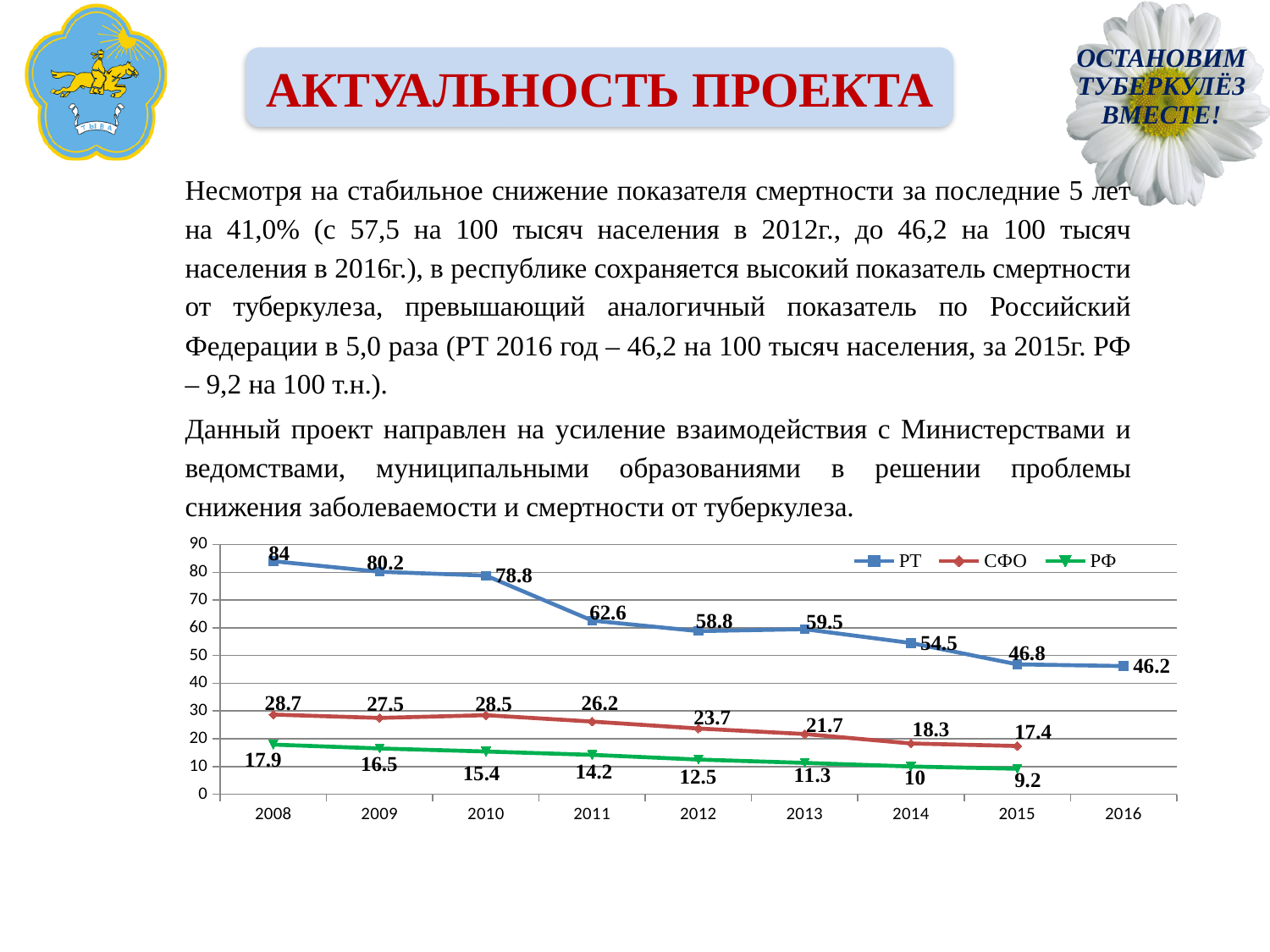
What is the value for РТ in 2016? 46.2 Which is larger in 2013: the value for СФО or the value for РФ? СФО What is the value for РФ in 2015? 9.2 What is the difference between the РТ values in 2008 and 2016? 37.8 What is the value for СФО in 2010? 28.5 Does the РТ series generally rise or fall from 2008 to 2016? fall How many series does the chart legend list? 3 In which year is the РФ series lowest? 2015 Which series is drawn with a green line in the chart? РФ How many years are shown on the x axis of the chart? 9 In which year is the РТ series highest? 2008 What kind of chart is shown on the slide? line chart